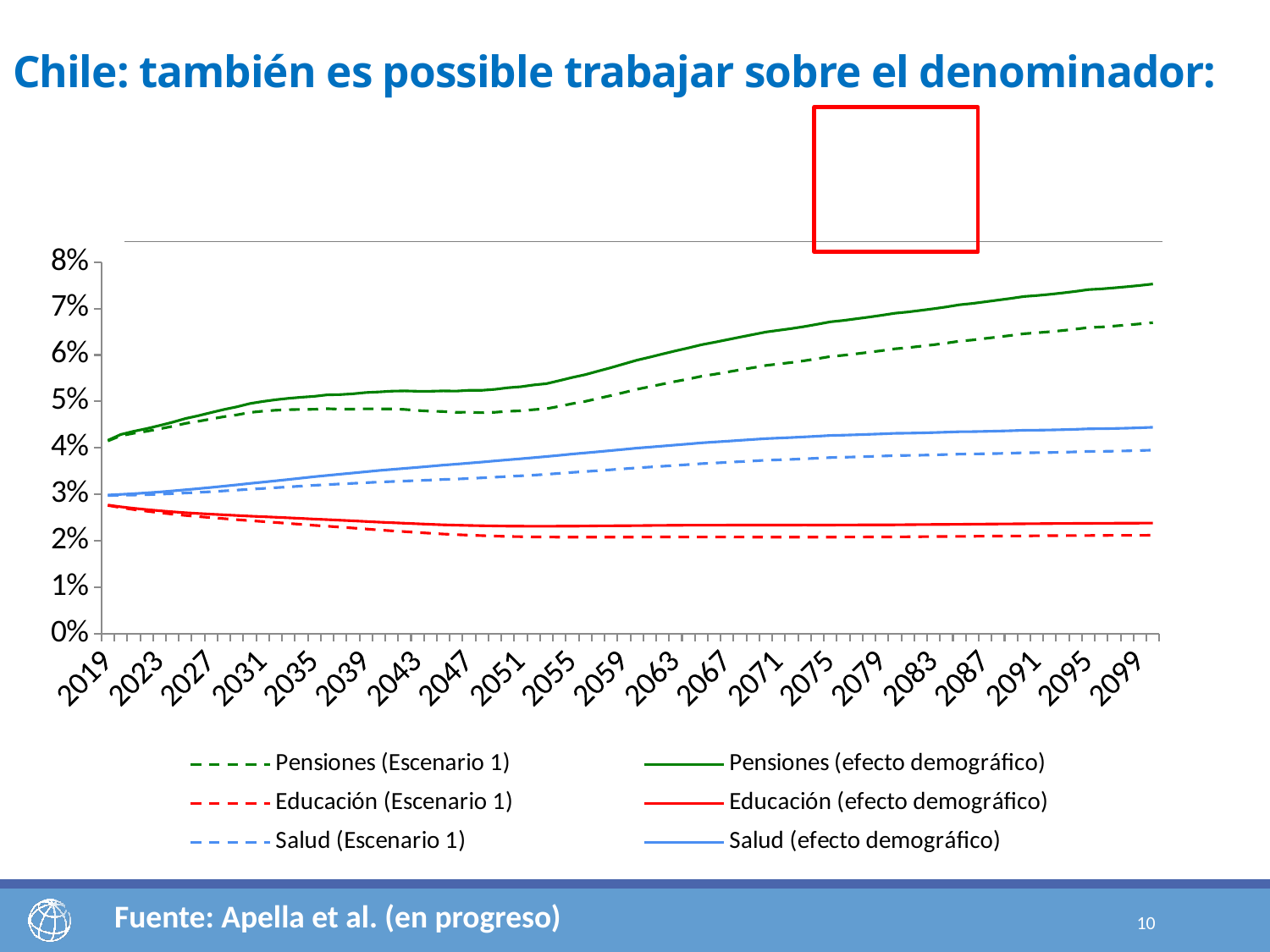
What kind of chart is shown on the slide? line chart Which series has the highest value in 2099? Pensiones (efecto demográfico) What line style is used for the Escenario 1 series in the legend? dashed Is the value for Pensiones (Escenario 1) in 2099 greater or less than 6%? greater Does the Educación (efecto demográfico) series rise or fall from 2019 to 2099? fall How many series does the legend list? 6 Is the value for Pensiones (efecto demográfico) in 2099 greater or less than 7%? greater Which series has the lowest value in 2099? Educación (Escenario 1) Is the value for Educación (efecto demográfico) in 2099 greater or less than 3%? less Does the Pensiones (efecto demográfico) series rise or fall from 2019 to 2099? rise In 2099, which is larger: Pensiones (efecto demográfico) or Pensiones (Escenario 1)? Pensiones (efecto demográfico)